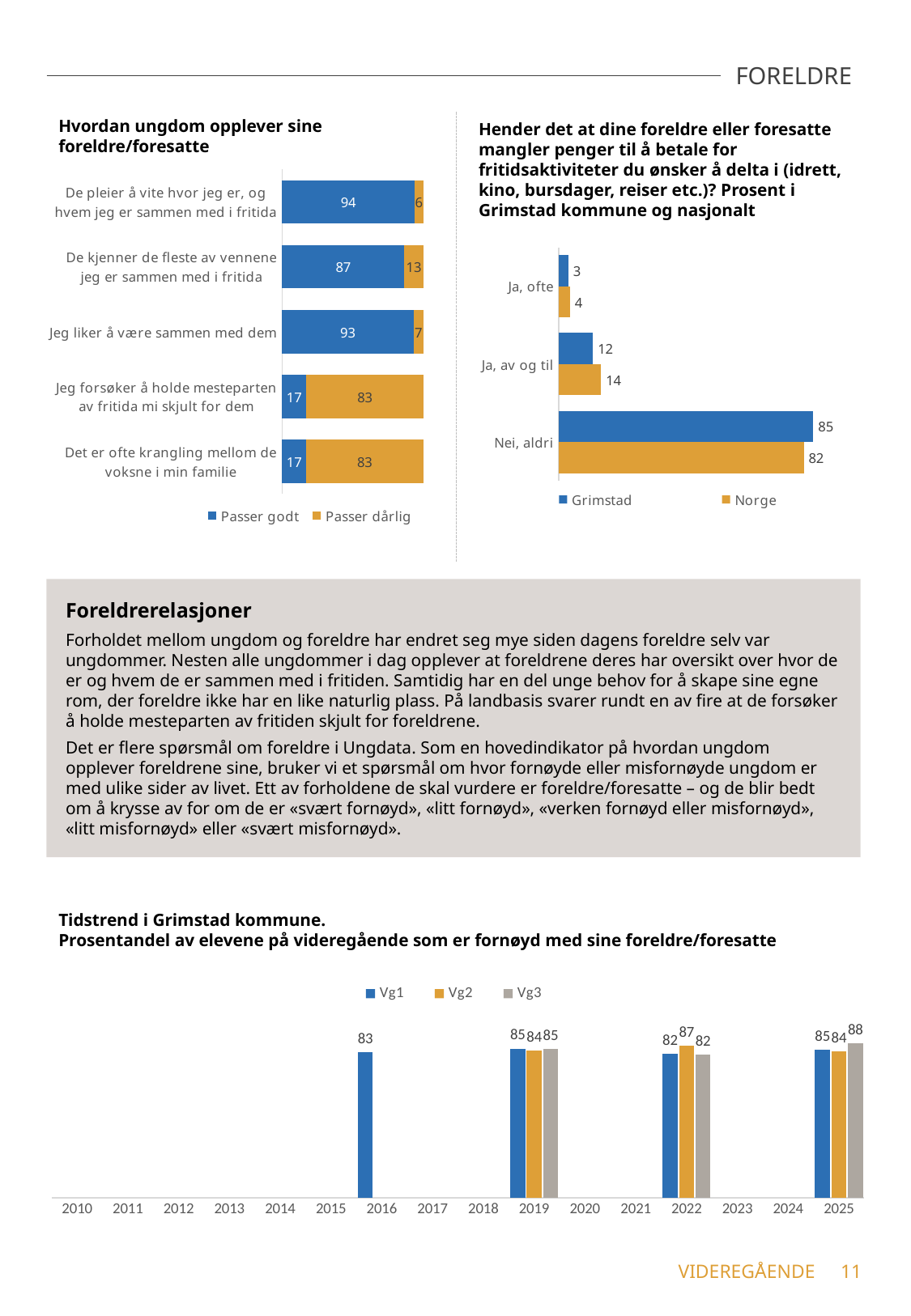
In the chart 'Tidstrend i Grimstad kommune', how many series does the legend list? 3 In the chart 'Hvordan ungdom opplever sine foreldre/foresatte', what is the 'Passer dårlig' value for 'De kjenner de fleste av vennene jeg er sammen med i fritida'? 13 In the chart 'Hender det at dine foreldre eller foresatte mangler penger...', what is the difference between Grimstad and Norge for 'Nei, aldri'? 3 In the chart 'Hvordan ungdom opplever sine foreldre/foresatte', what is the total of the stacked bar for 'Jeg liker å være sammen med dem'? 100 In the chart 'Hender det at dine foreldre eller foresatte mangler penger...', which series does the legend list besides Grimstad? Norge In the chart 'Hender det at dine foreldre eller foresatte mangler penger...', what is the value for Norge for 'Ja, av og til'? 14 In the chart 'Tidstrend i Grimstad kommune', what is the Vg3 value for 2025? 88 In the chart 'Hvordan ungdom opplever sine foreldre/foresatte', what is the 'Passer godt' value for 'De pleier å vite hvor jeg er, og hvem jeg er sammen med i fritida'? 94 In the chart 'Hender det at dine foreldre eller foresatte mangler penger...', is the Grimstad value for 'Ja, ofte' larger or smaller than the Norge value? smaller In the chart 'Tidstrend i Grimstad kommune', what kind of chart is it? bar chart In the chart 'Hvordan ungdom opplever sine foreldre/foresatte', which statement has the lowest 'Passer godt' value? Jeg forsøker å holde mesteparten av fritida mi skjult for dem and Det er ofte krangling mellom de voksne i min familie (both 17) In the chart 'Hvordan ungdom opplever sine foreldre/foresatte', how many statements are shown? 5